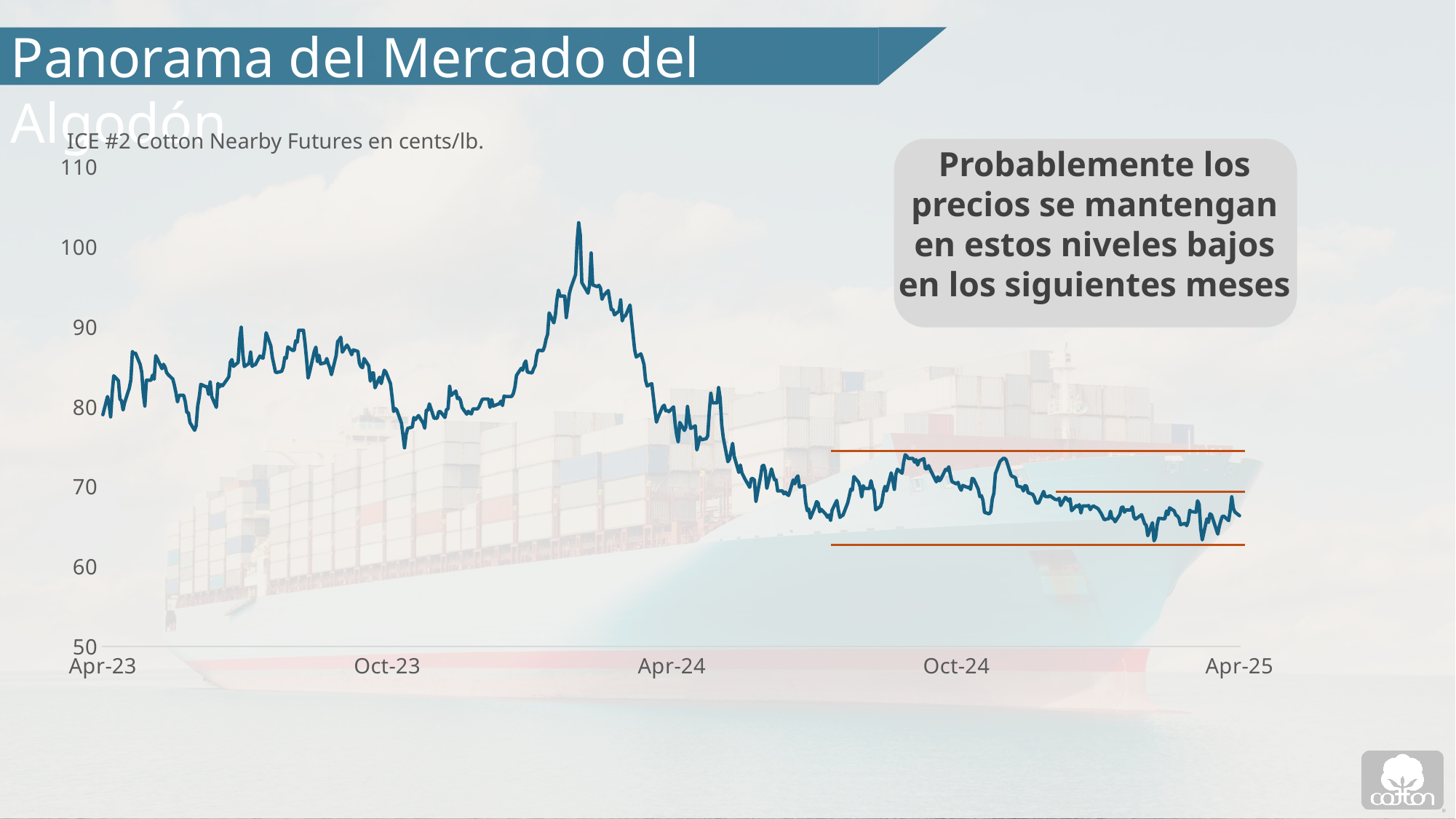
Near which x-axis label does the line reach its lowest point? Apr-25 In what units are the values on the chart expressed? cents/lb Is the value around Oct-23 greater or less than 80? greater What kind of chart is shown on the slide? line chart Is the highest value reached by the line greater or less than 100? greater Do the values rise or fall between Apr-24 and Oct-24? fall What is the title of the chart? ICE #2 Cotton Nearby Futures en cents/lb. Overall, do the values rise or fall from Apr-23 to Apr-25? fall How many date labels are shown on the x axis? 5 Near which x-axis label does the line reach its highest point? Apr-24 How many data series (lines) are plotted on the chart? 1 Is the value at the end of the series, near Apr-25, greater or less than 70? less